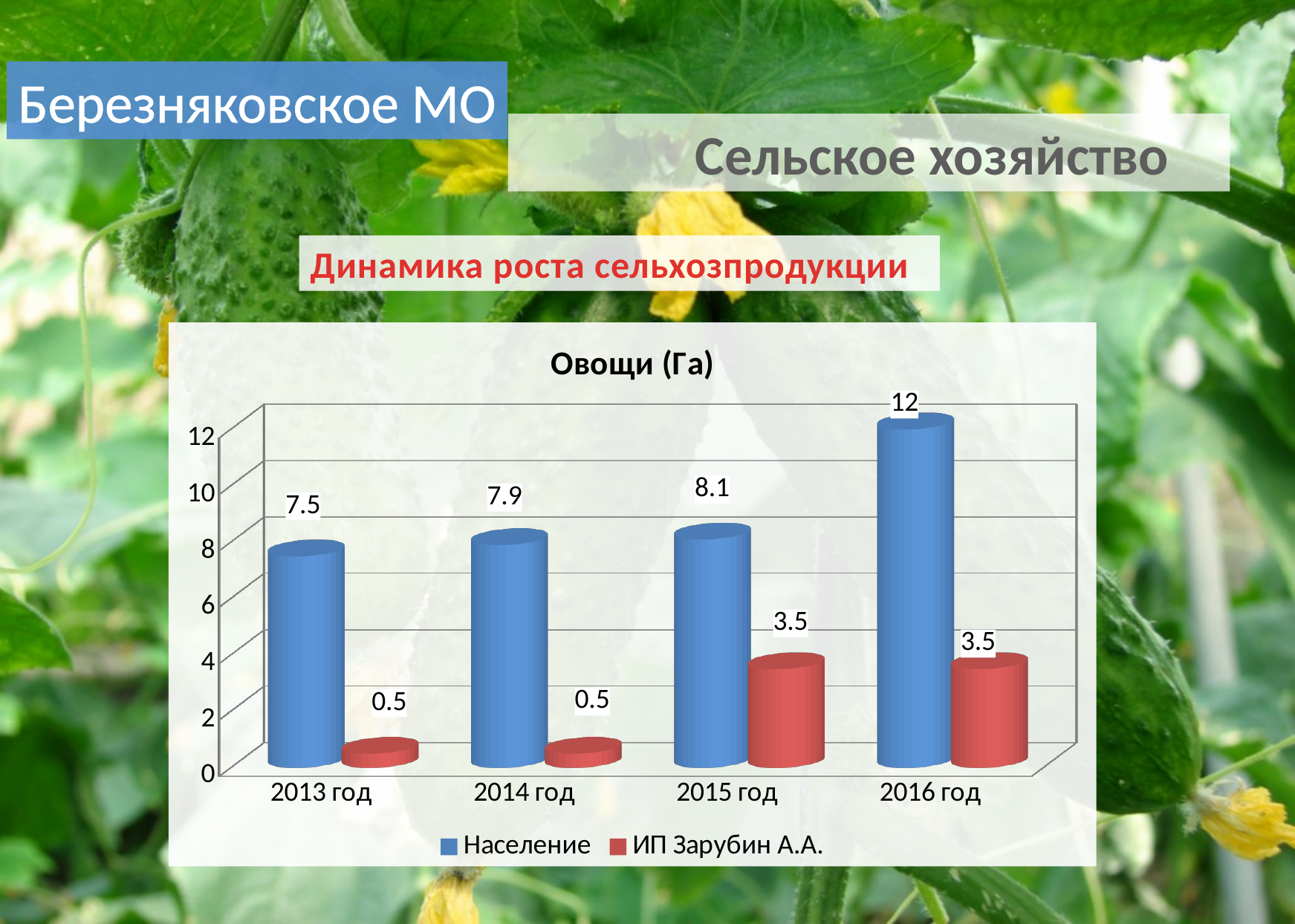
Do the values for Население rise or fall from 2013 год to 2016 год? rise What is the value for Население in 2013 год? 7.5 Which is larger in 2014 год: Население or ИП Зарубин А.А.? Население In which years is the value for ИП Зарубин А.А. lowest? 2013 год and 2014 год What is the difference between the Население values for 2016 год and 2015 год? 3.9 What kind of chart is shown? bar chart What is the difference between Население and ИП Зарубин А.А. in 2016 год? 8.5 In which year is the value for Население highest? 2016 год What is the value for ИП Зарубин А.А. in 2015 год? 3.5 How many series does the legend list? 2 How many years are shown on the x axis? 4 What is the value for Население in 2016 год? 12